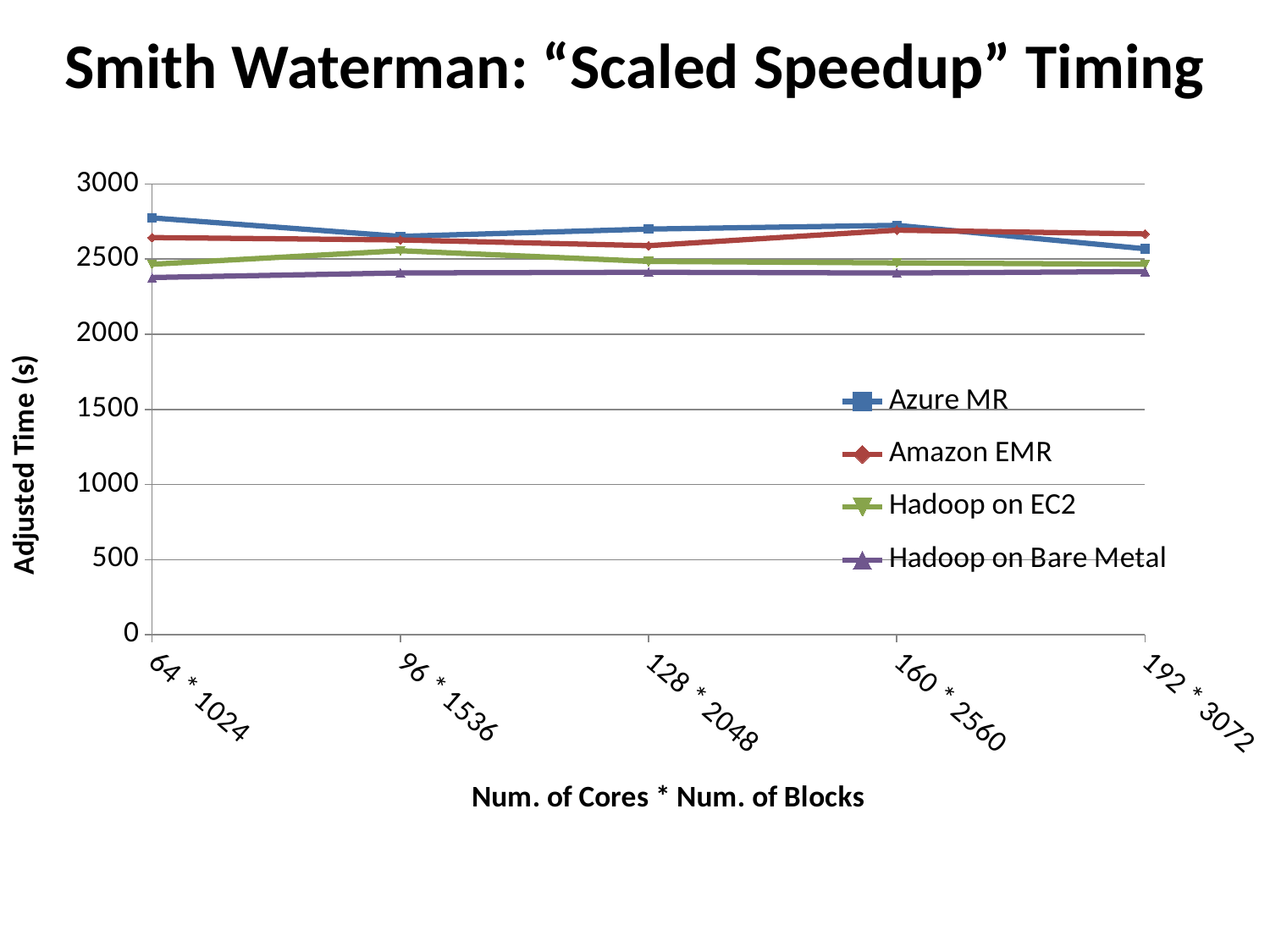
Does the Azure MR line rise or fall from 160 * 2560 to 192 * 3072? fall At 64 * 1024, which is larger: Azure MR or Hadoop on Bare Metal? Azure MR Which series has the lowest value at 64 * 1024? Hadoop on Bare Metal Is the value for Hadoop on EC2 at 192 * 3072 greater or less than 2000? greater What is the title of the x axis? Num. of Cores * Num. of Blocks Which series has the highest value at 64 * 1024? Azure MR Is the value for Azure MR at 64 * 1024 greater or less than 2500? greater Is the value for Hadoop on Bare Metal at 64 * 1024 greater or less than 2500? less What is the title of the y axis? Adjusted Time (s) How many points are plotted along the x axis for each series? 5 What kind of chart is shown on the slide? line chart How many series does the legend list? 4